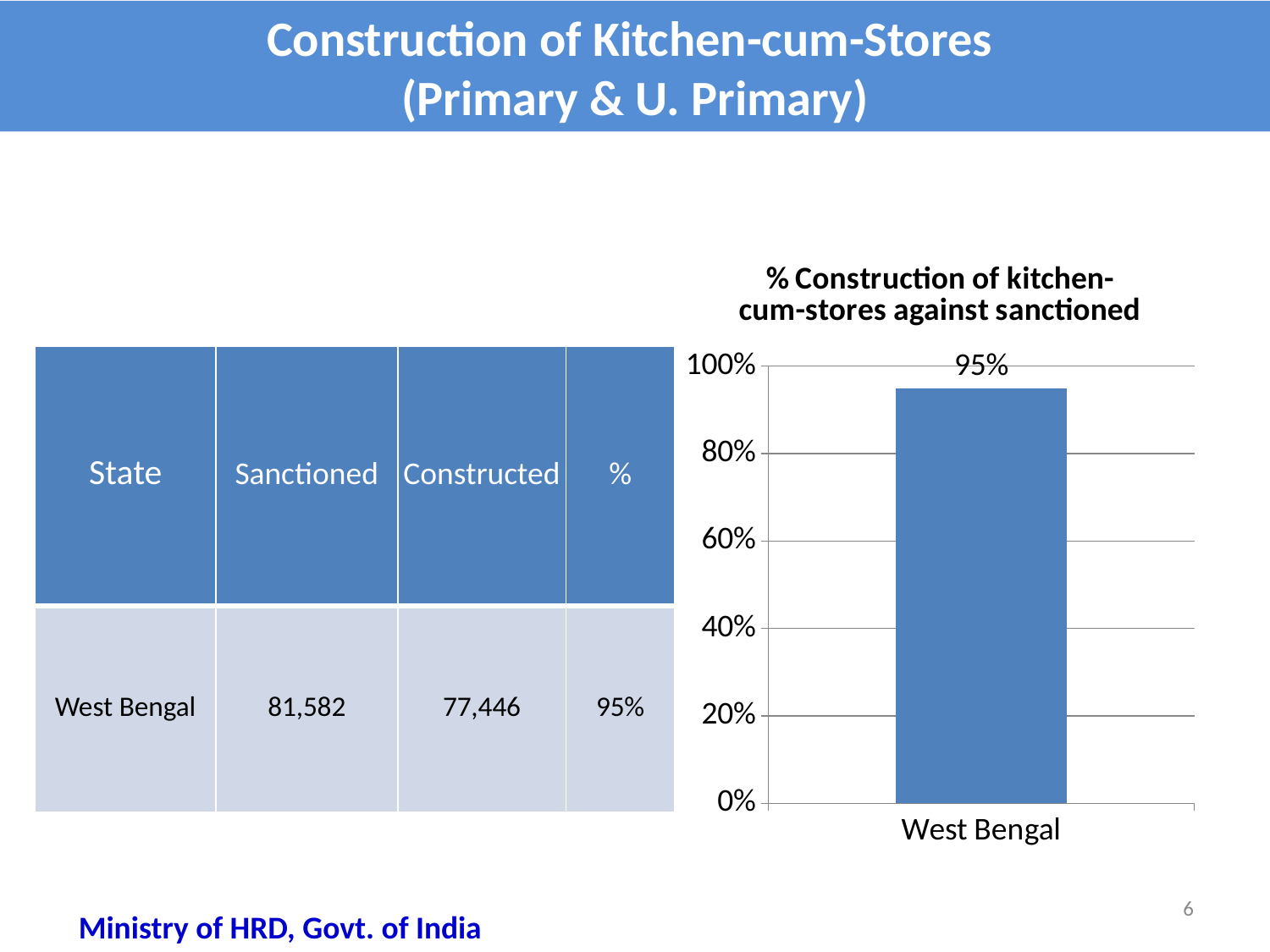
What is the title of the chart? % Construction of kitchen-cum-stores against sanctioned Which category is labelled on the x axis of the chart? West Bengal Is the value for West Bengal greater or less than 100%? less What type of chart is shown on the slide? bar chart What is the highest value shown on the chart's vertical axis? 100% Is the value for West Bengal greater or less than 80%? greater How many categories are plotted in the chart? 1 What is the value for West Bengal in the chart? 95%